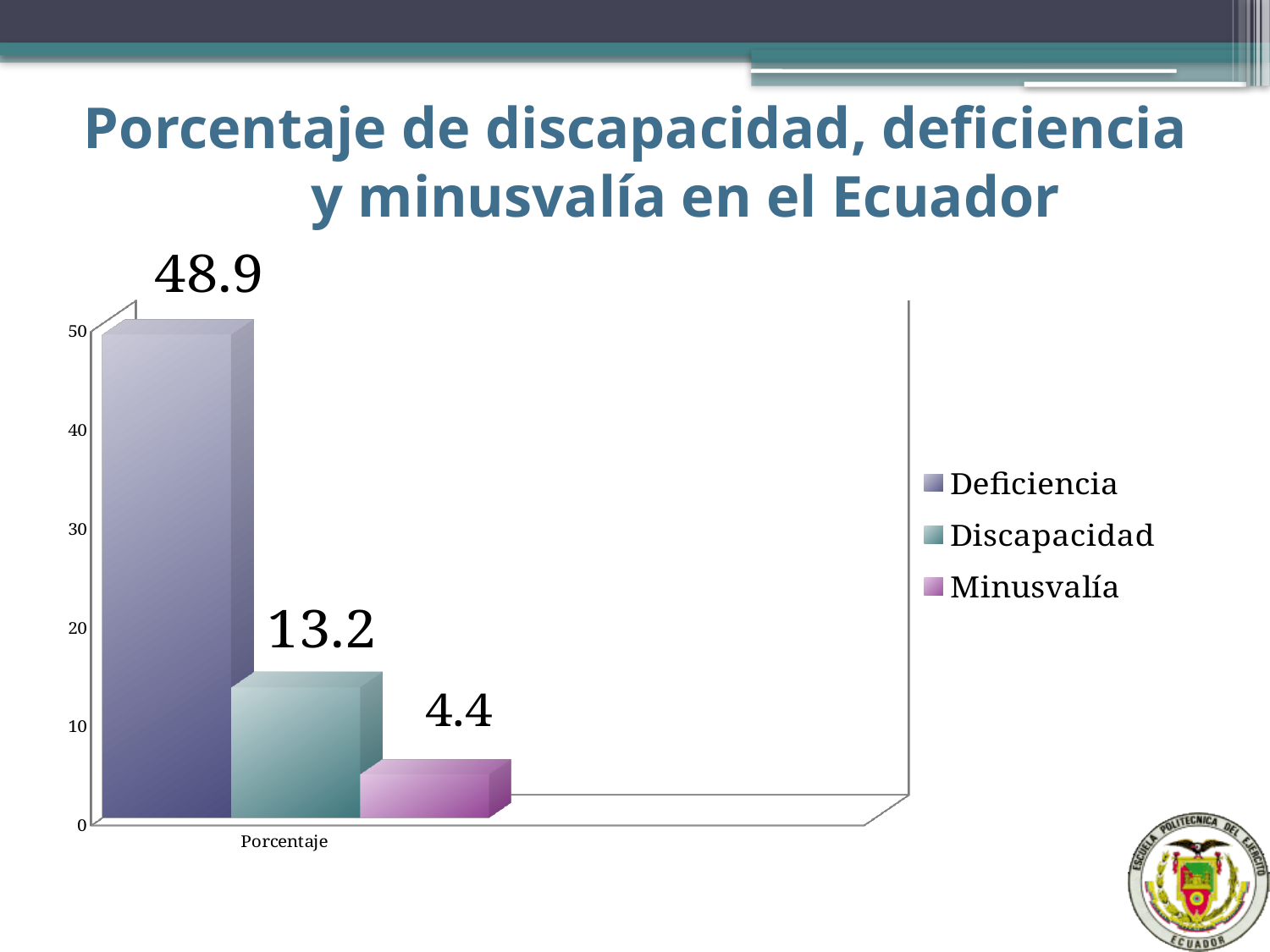
What is the value for Deficiencia? 48.9 What is the value for Minusvalía? 4.4 What is the difference between the values for Discapacidad and Minusvalía? 8.8 Is the value for Deficiencia greater or less than 40? greater Which is larger, the value for Discapacidad or the value for Minusvalía? Discapacidad What is the label on the x axis category? Porcentaje What is the value for Discapacidad? 13.2 What kind of chart is shown on the slide? bar chart Which series has the highest value? Deficiencia Which series has the lowest value? Minusvalía How many series does the legend list? 3 What is the difference between the values for Deficiencia and Discapacidad? 35.7